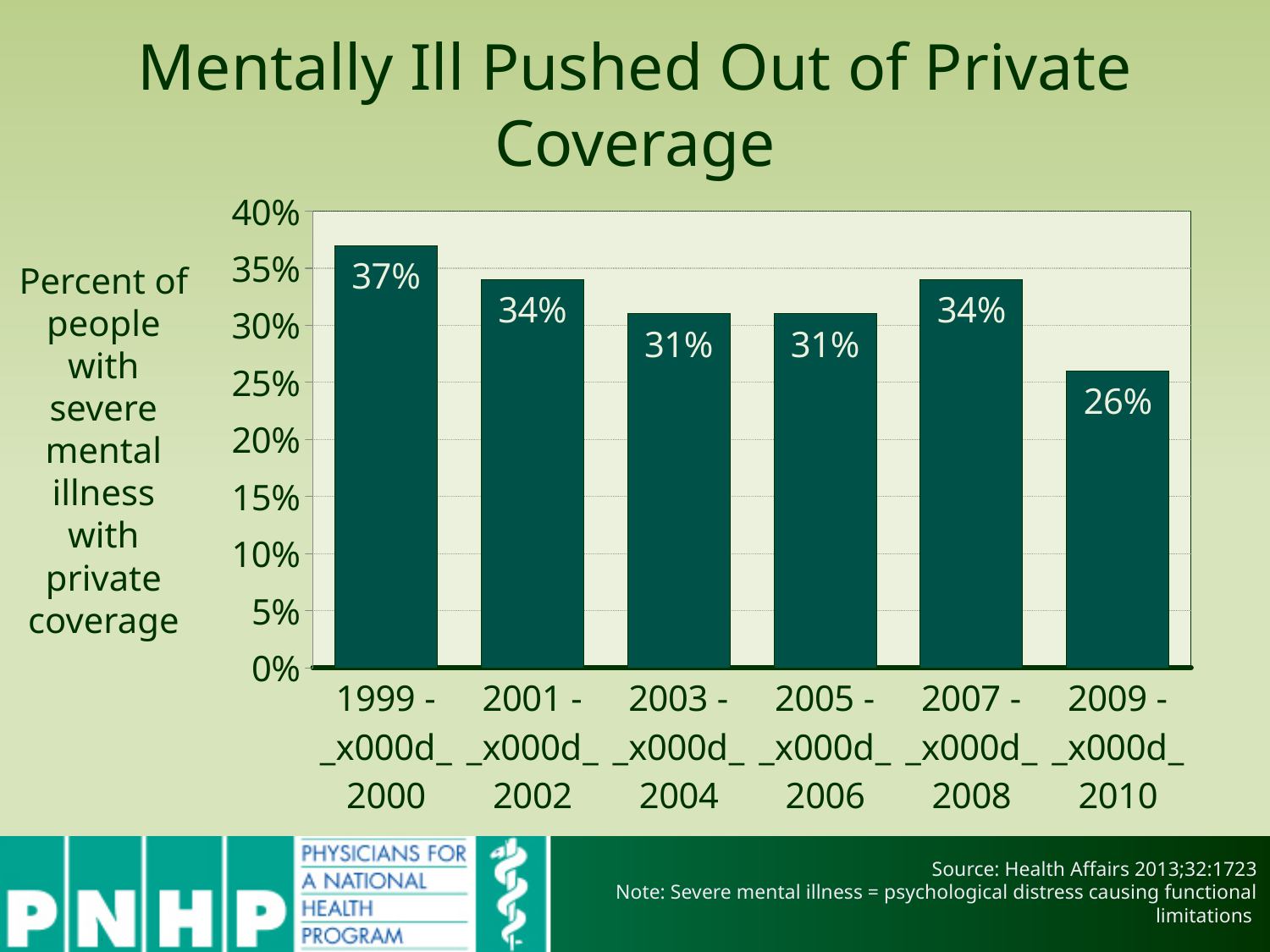
Which period has the highest value? 1999 - 2000 What is the value for 2009 - 2010? 26% What is the difference between the values for 1999 - 2000 and 2009 - 2010? 11% How many periods are shown on the x axis? 6 Which is larger, the value for 2007 - 2008 or the value for 2009 - 2010? 2007 - 2008 What kind of chart is shown on the slide? bar chart What is the value for 2003 - 2004? 31% What is the title of the slide's chart? Mentally Ill Pushed Out of Private Coverage Which period has the lowest value? 2009 - 2010 Is the value for 2009 - 2010 greater or less than 30%? less What is the difference between the values for 2001 - 2002 and 2003 - 2004? 3% What is the value for 1999 - 2000? 37%